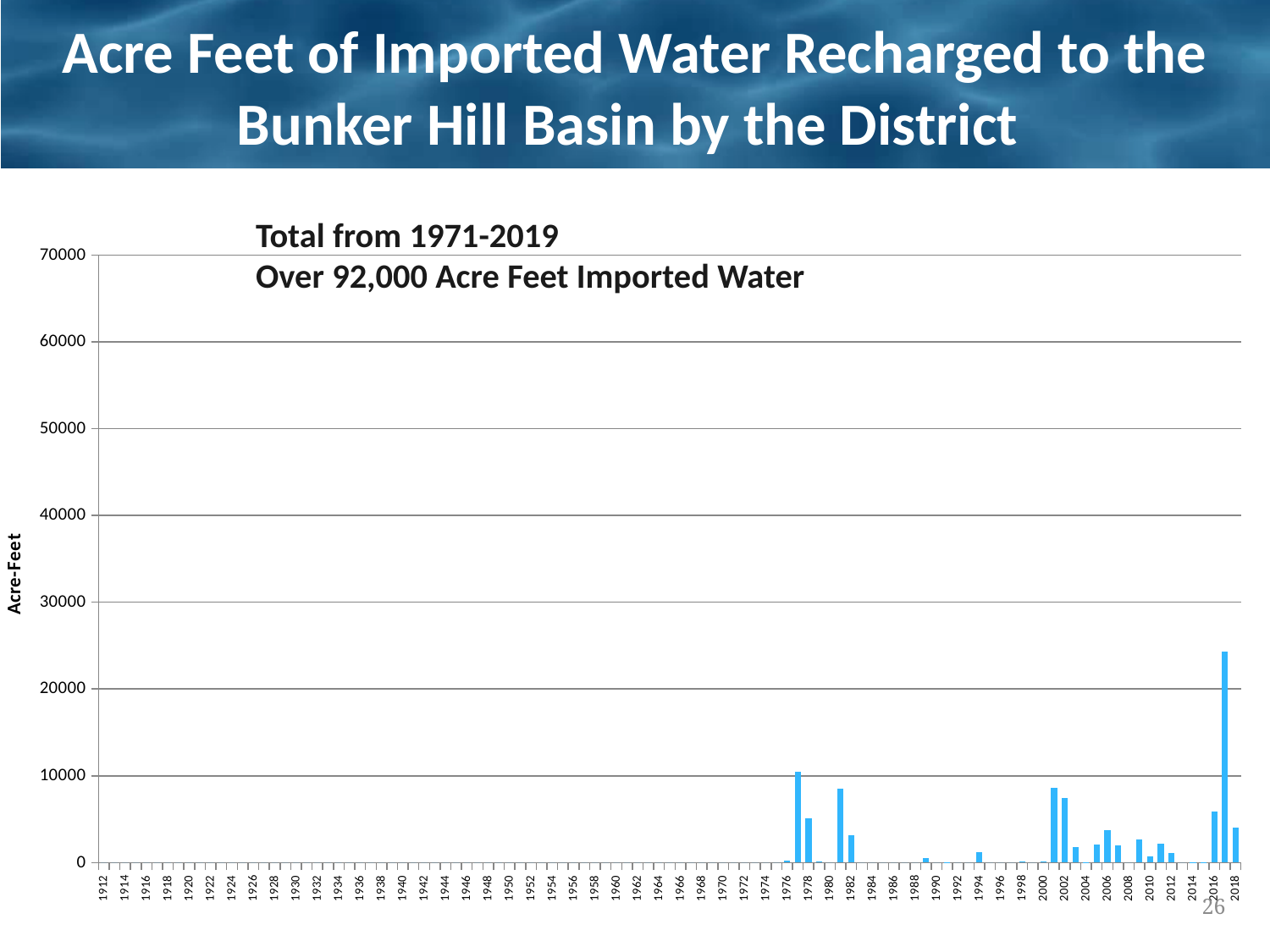
Is the value for the tallest bar in the chart greater or less than 30000? less Is the value for the tallest bar in the chart greater or less than 20000? greater What is the label on the vertical axis of the chart? Acre-Feet Is the value for 2001 greater or less than 10000? less What is the first year label shown on the horizontal axis? 1912 What kind of chart is shown on the slide? bar chart Which year has a larger value, 2017 or 1977? 2017 What is the highest value shown on the vertical axis of the chart? 70000 Which year has a larger value, 1977 or 1981? 1977